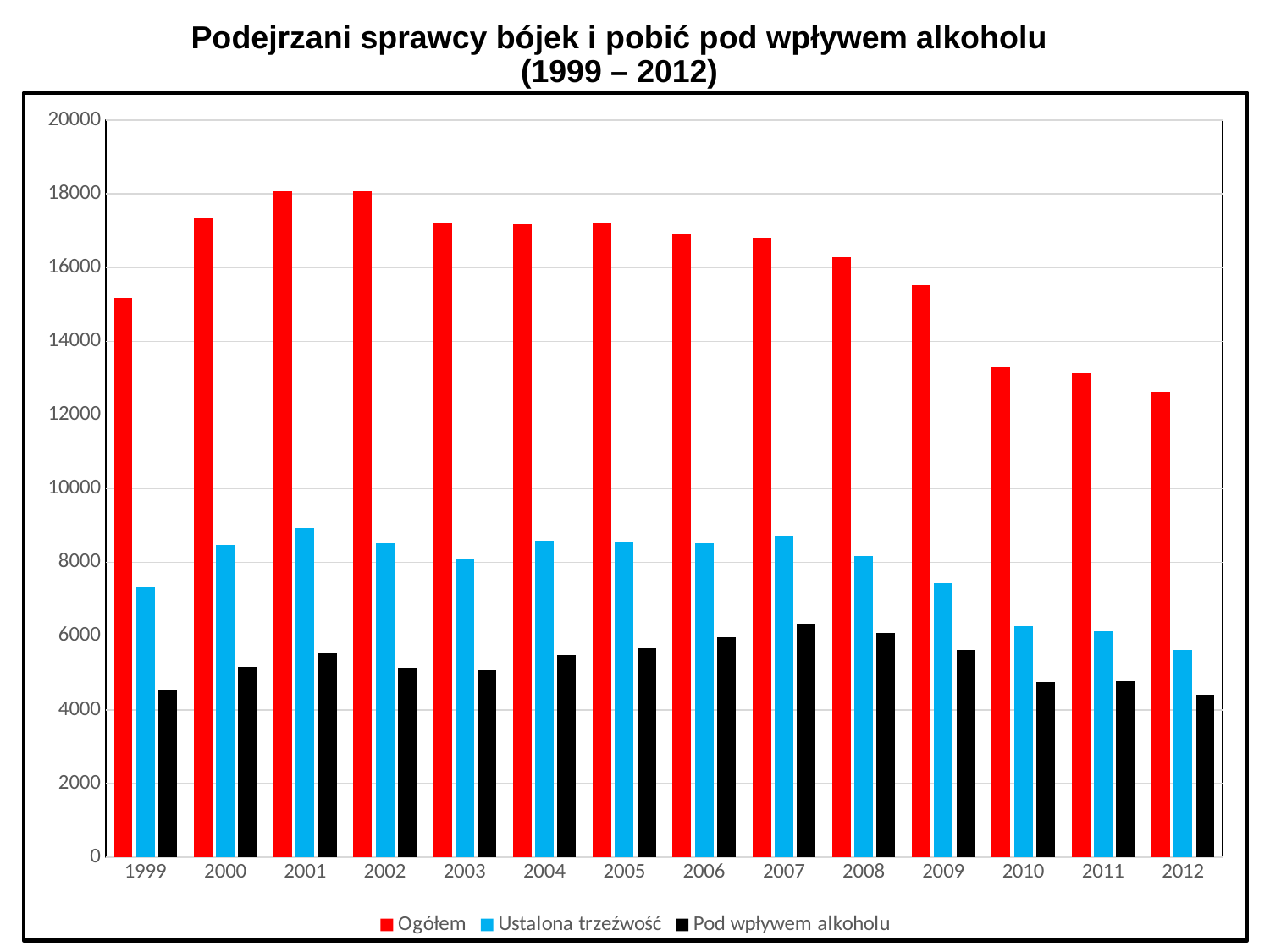
How many series does the legend list? 3 In which year is the value for Pod wpływem alkoholu highest? 2007 Is the value for Ogółem in 2012 greater or less than 14000? less Is the value for Ogółem in 1999 greater or less than 14000? greater Do the values for Ogółem rise or fall from 2002 to 2012? fall What kind of chart is shown on the slide? bar chart Which is larger, the value for Ogółem in 2000 or in 2009? 2000 Is the value for Pod wpływem alkoholu in 2007 greater or less than 6000? greater In which year is the value for Ogółem lowest? 2012 In which year is the value for Ustalona trzeźwość lowest? 2012 How many years are shown on the x axis? 14 What colour are the bars for the Ogółem series? red